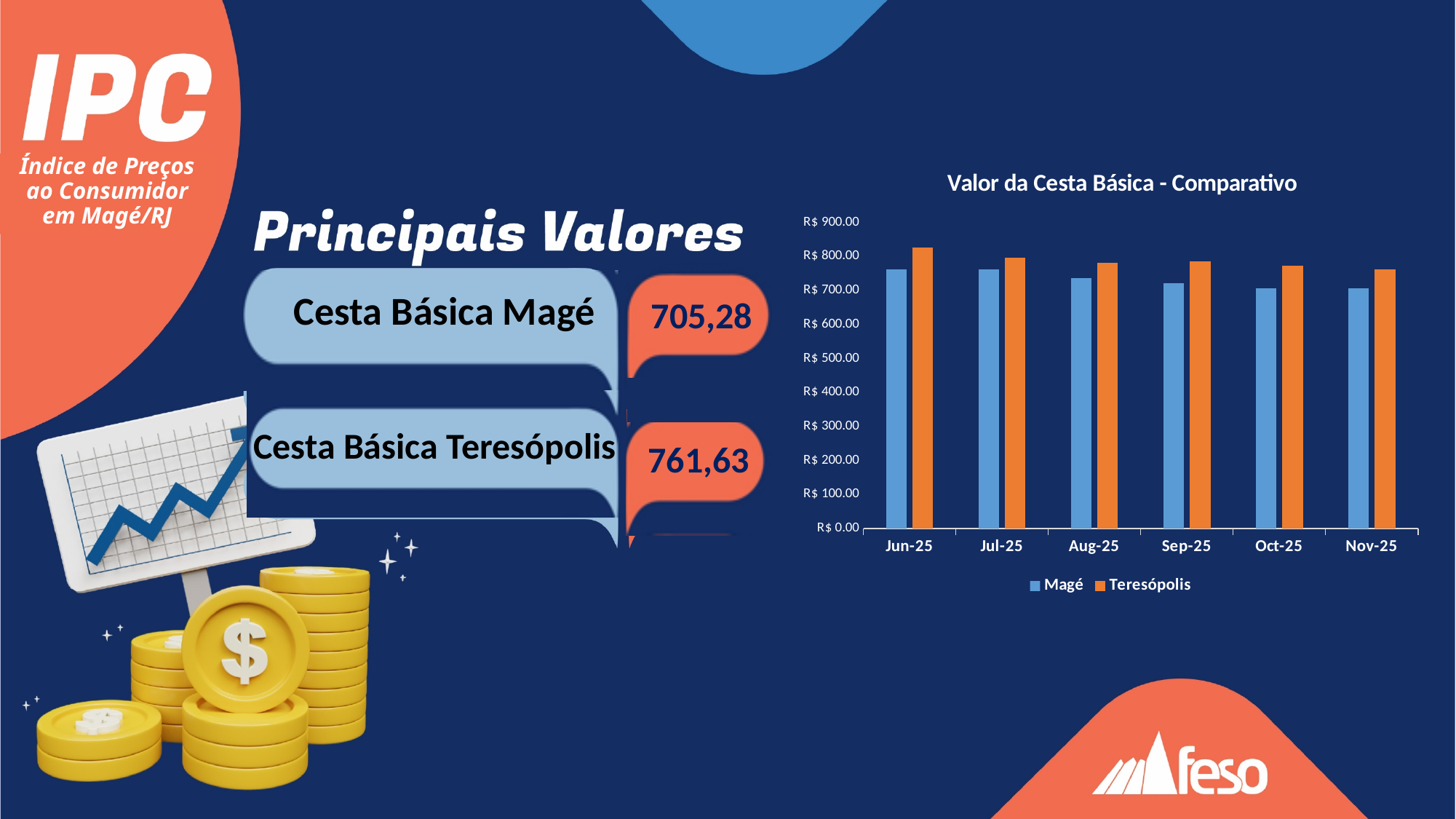
Is the value for Magé in Jun-25 greater or less than R$ 800.00? less In Jun-25, which series has the larger value, Magé or Teresópolis? Teresópolis Is the value for Teresópolis in Jun-25 greater or less than R$ 800.00? greater Is the value for Magé in Sep-25 greater or less than R$ 600.00? greater In which month is the Teresópolis value highest? Jun-25 Which series is shown in orange in the chart? Teresópolis Do the Magé values rise or fall from Jun-25 to Nov-25? fall What kind of chart is "Valor da Cesta Básica - Comparativo"? bar chart What is the title of the chart on the slide? Valor da Cesta Básica - Comparativo How many series does the legend of the chart list? 2 How many months are shown on the x axis of the chart? 6